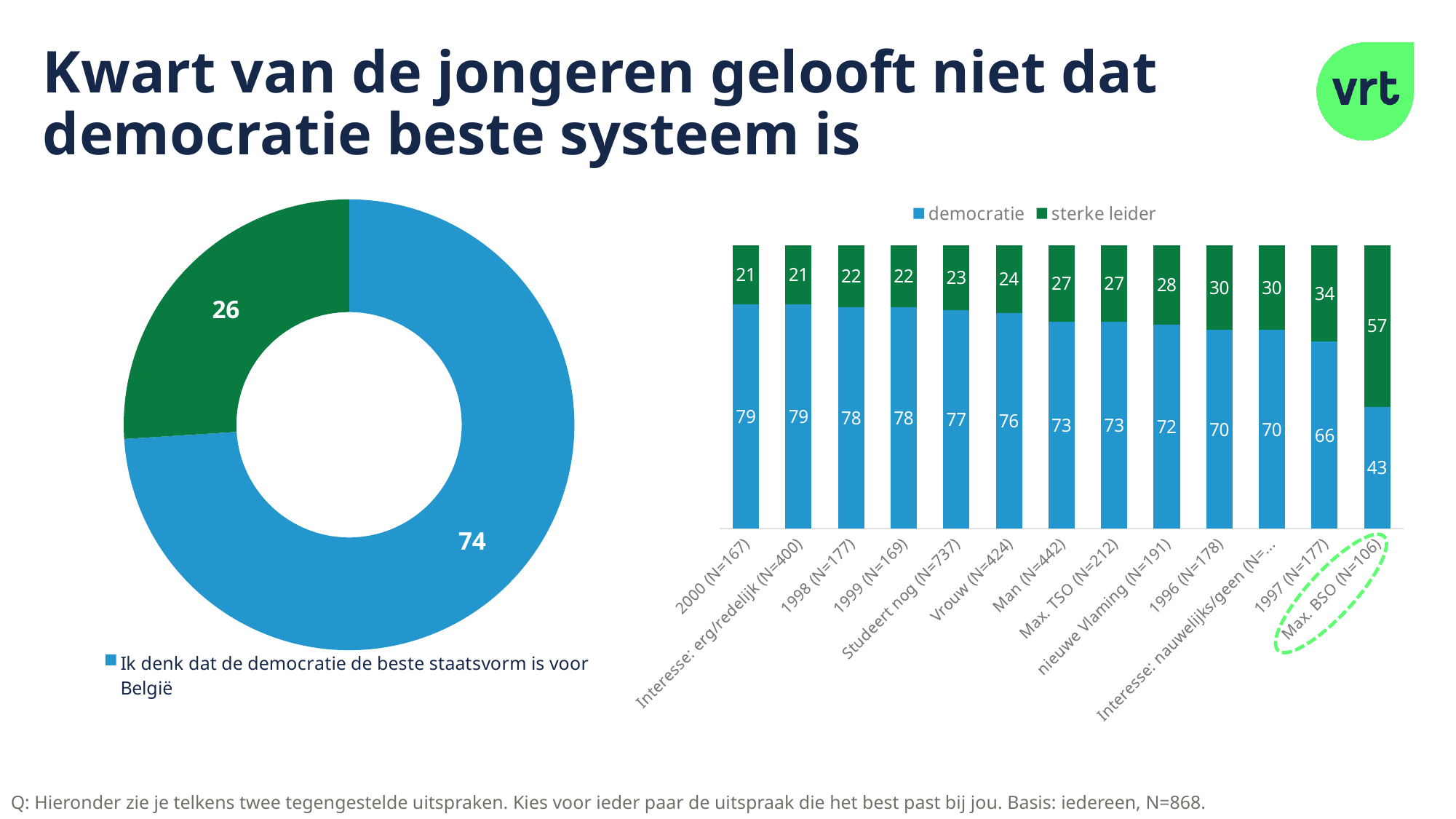
In the stacked bar chart on the right, which category has the highest 'sterke leider' value? Max. BSO (N=106) How many series does the legend of the stacked bar chart on the right list? 2 What kind of chart is shown on the left of the slide? Donut (pie) chart In the stacked bar chart on the right, which category has the lowest 'democratie' value? Max. BSO (N=106) In the stacked bar chart on the right, what is the total of the stacked bar for 'Studeert nog (N=737)'? 100 In the donut chart on the left, what value is shown for the segment 'Ik denk dat de democratie de beste staatsvorm is voor België'? 74 In the donut chart on the left, what value is shown for the green segment? 26 How many categories are shown in the stacked bar chart on the right? 13 In the stacked bar chart on the right, what is the 'democratie' value for 'Max. BSO (N=106)'? 43 In the stacked bar chart on the right, what is the 'sterke leider' value for '1997 (N=177)'? 34 In the stacked bar chart on the right, what is the difference between the 'democratie' values for 'Vrouw (N=424)' and 'Man (N=442)'? 3 In the stacked bar chart on the right, which is larger: the 'sterke leider' value for '1996 (N=178)' or for '1998 (N=177)'? 1996 (N=178)